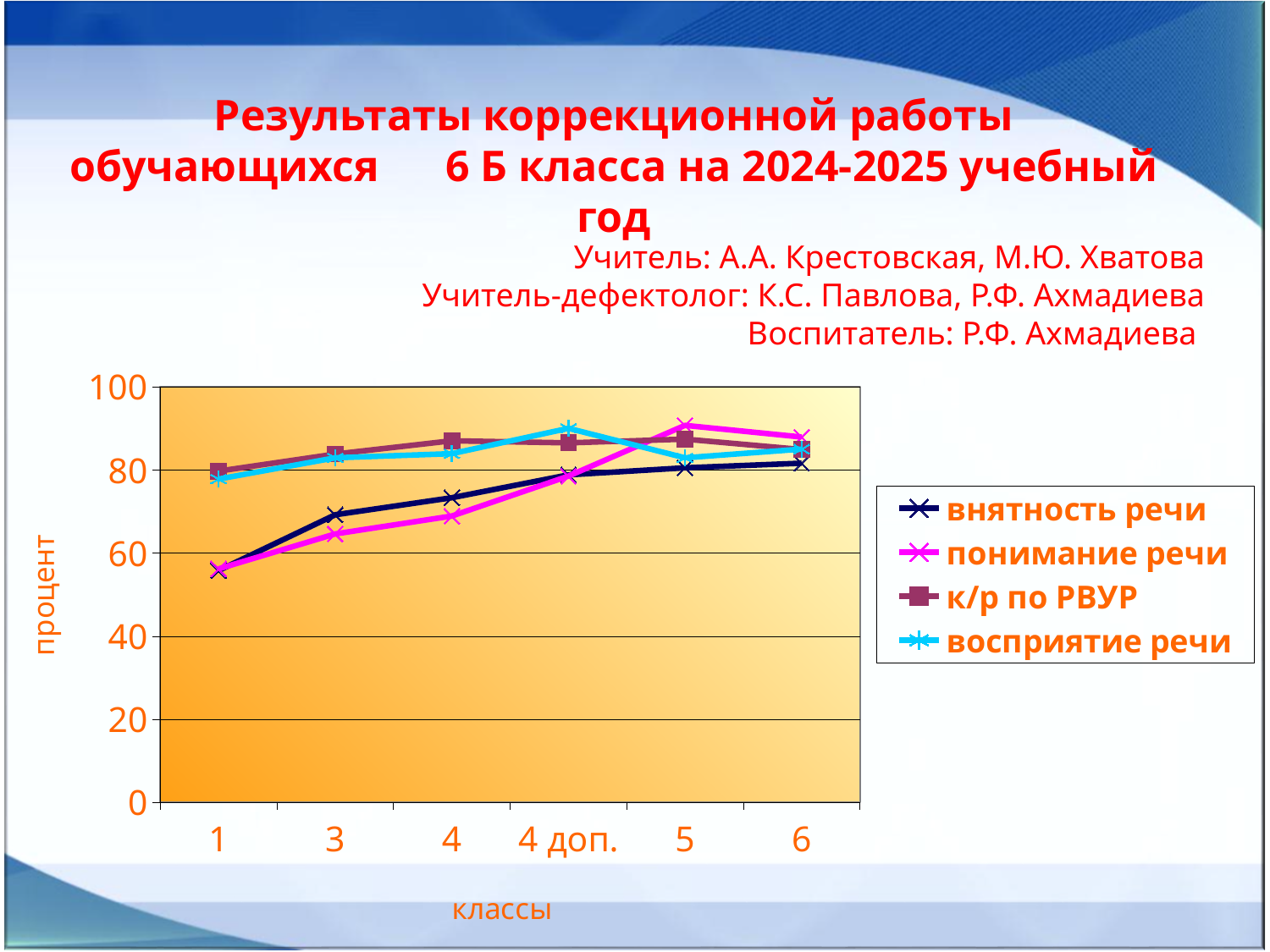
At category 1, which is larger: к/р по РВУР or внятность речи? к/р по РВУР Is the value for восприятие речи at category 4 доп. greater or less than 80? greater Is the value for внятность речи at category 1 greater or less than 60? less At category 5, which is larger: понимание речи or внятность речи? понимание речи What is the label of the y axis? процент Is the value for понимание речи at category 5 greater or less than 80? greater How many categories are shown on the x axis? 6 How many series does the legend list? 4 Do the values for внятность речи rise or fall from category 1 to category 6? rise What is the label of the x axis? классы What kind of chart is shown on the slide? line chart